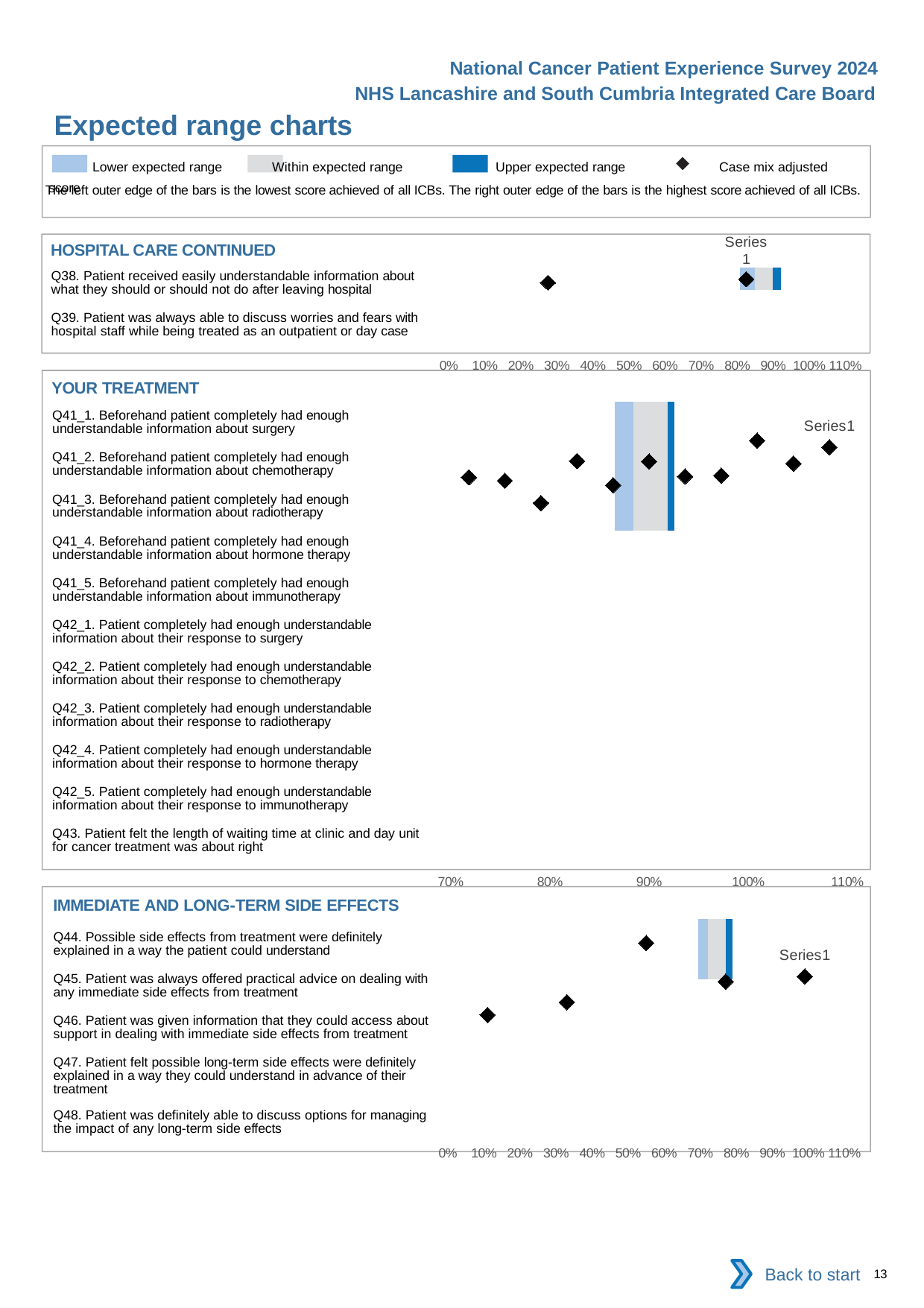
How many questions are listed in the IMMEDIATE AND LONG-TERM SIDE EFFECTS chart? 5 Which of the three charts on the slide lists the fewest questions? HOSPITAL CARE CONTINUED How many questions are listed in the YOUR TREATMENT chart? 11 How many entries does the legend at the top of the slide list? 4 How many questions are listed in the HOSPITAL CARE CONTINUED chart? 2 Which of the three charts on the slide lists the most questions? YOUR TREATMENT In the HOSPITAL CARE CONTINUED chart, what is the highest value shown on the horizontal axis? 110% In the YOUR TREATMENT chart, what is the lowest value shown on the horizontal axis? 70%